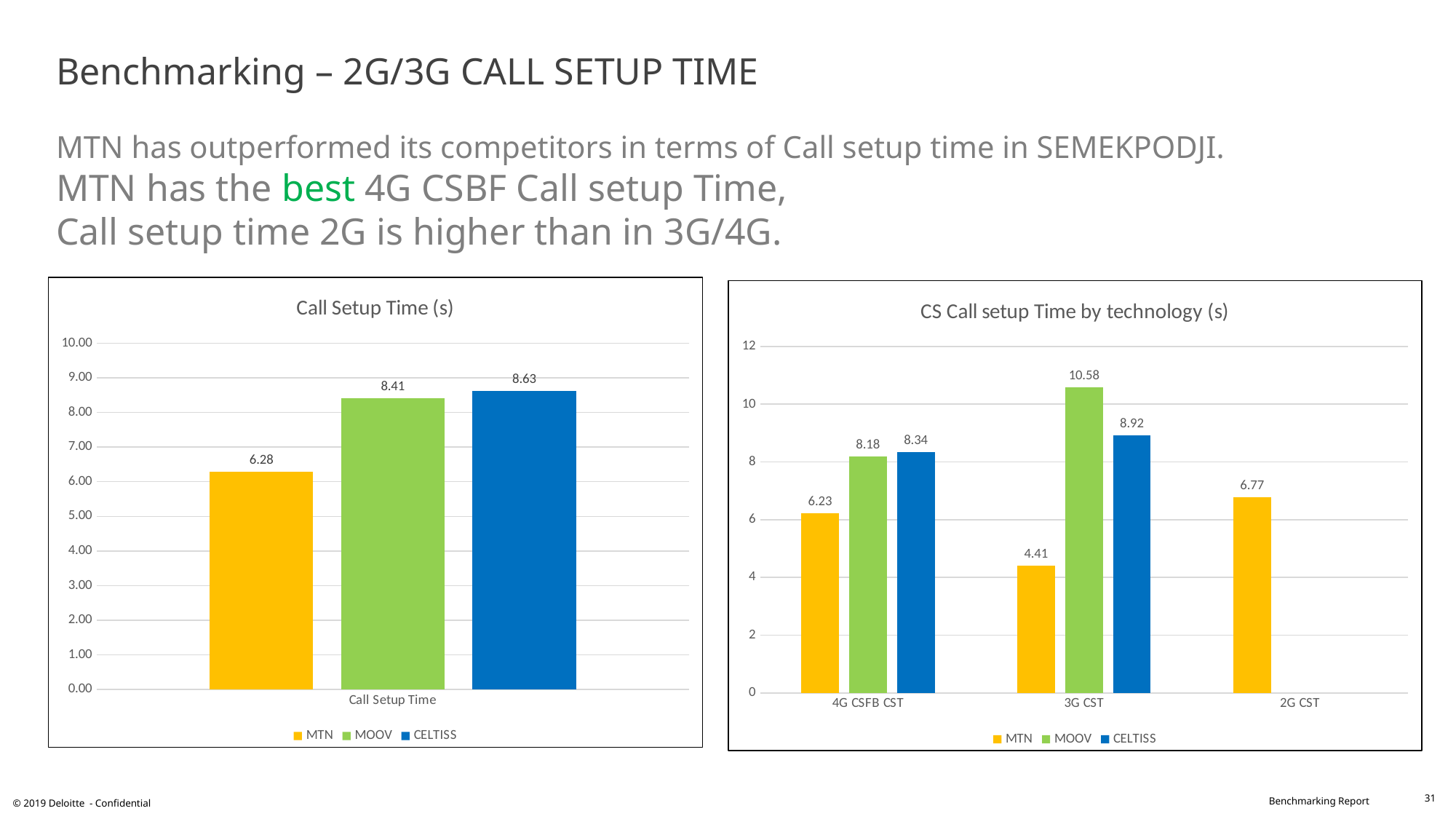
In the 'Call Setup Time (s)' chart, what is the value for MTN? 6.28 What type of chart is the 'CS Call setup Time by technology (s)' chart? Bar chart In the 'Call Setup Time (s)' chart, what is the difference between the CELTISS and MTN values? 2.35 In the 'CS Call setup Time by technology (s)' chart, what is the difference between the MOOV and MTN values for 3G CST? 6.17 In the 'CS Call setup Time by technology (s)' chart, what is the MOOV value for 3G CST? 10.58 In the 'CS Call setup Time by technology (s)' chart, is the CELTISS value for 4G CSFB CST larger or smaller than the MOOV value for 4G CSFB CST? larger In the 'CS Call setup Time by technology (s)' chart, what is the MTN value for 2G CST? 6.77 In the 'CS Call setup Time by technology (s)' chart, what colour represents MOOV? Green In the 'CS Call setup Time by technology (s)' chart, which operator has the lowest value for 3G CST? MTN In the 'CS Call setup Time by technology (s)' chart, how many technology categories are shown on the x axis? 3 In the 'Call Setup Time (s)' chart, how many series does the legend list? 3 In the 'Call Setup Time (s)' chart, which operator has the highest call setup time? CELTISS